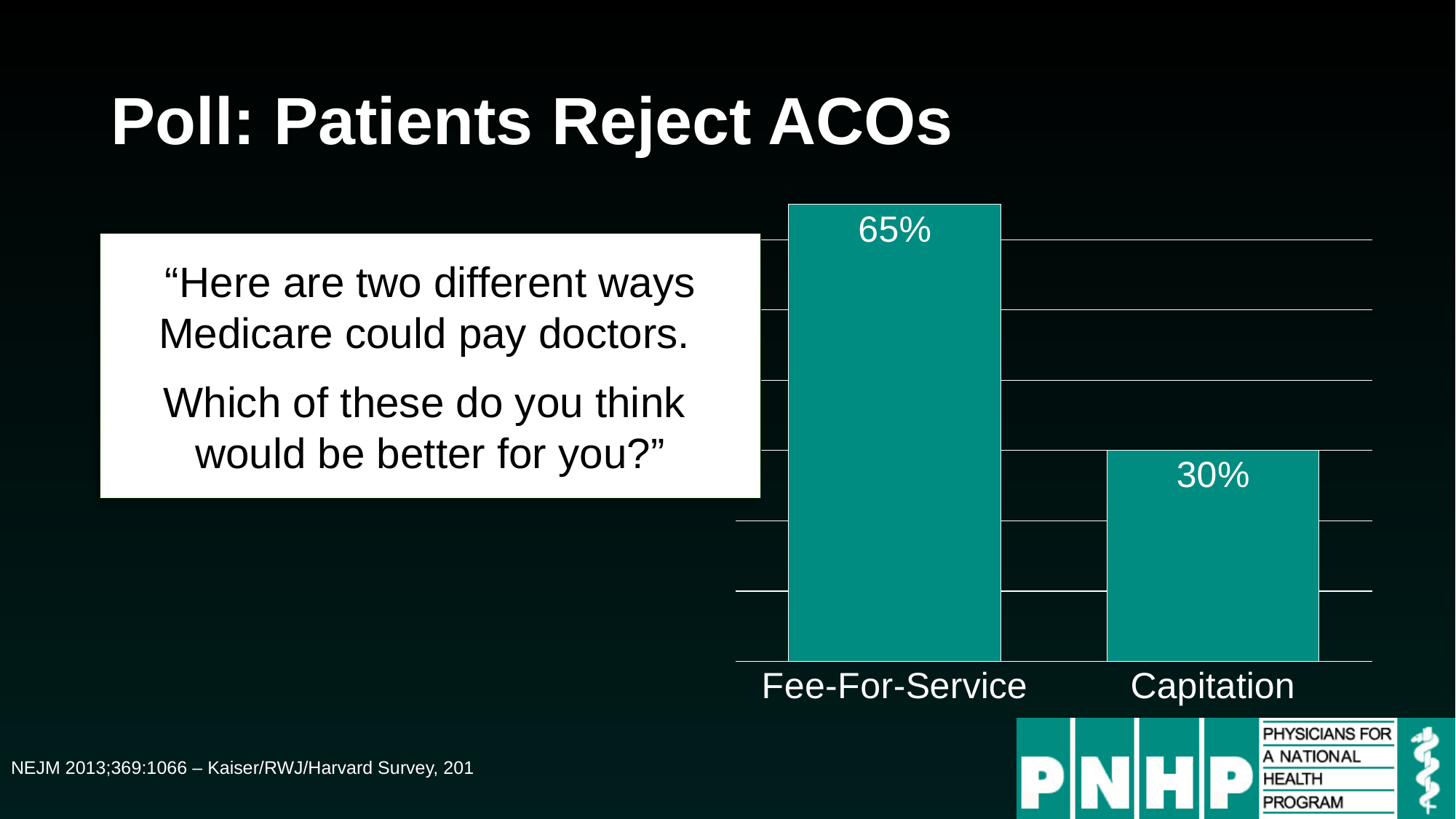
What colour are the bars in the chart? Teal Which category has the highest value? Fee-For-Service What kind of chart is shown on the slide? Bar chart What is the title of the slide containing the chart? Poll: Patients Reject ACOs How many categories are shown in the chart? 2 Which is larger, the value for Fee-For-Service or the value for Capitation? Fee-For-Service What is the difference between the Fee-For-Service and Capitation values? 35% Which category has the lowest value? Capitation What percentage of respondents chose Fee-For-Service? 65% What percentage of respondents chose Capitation? 30%